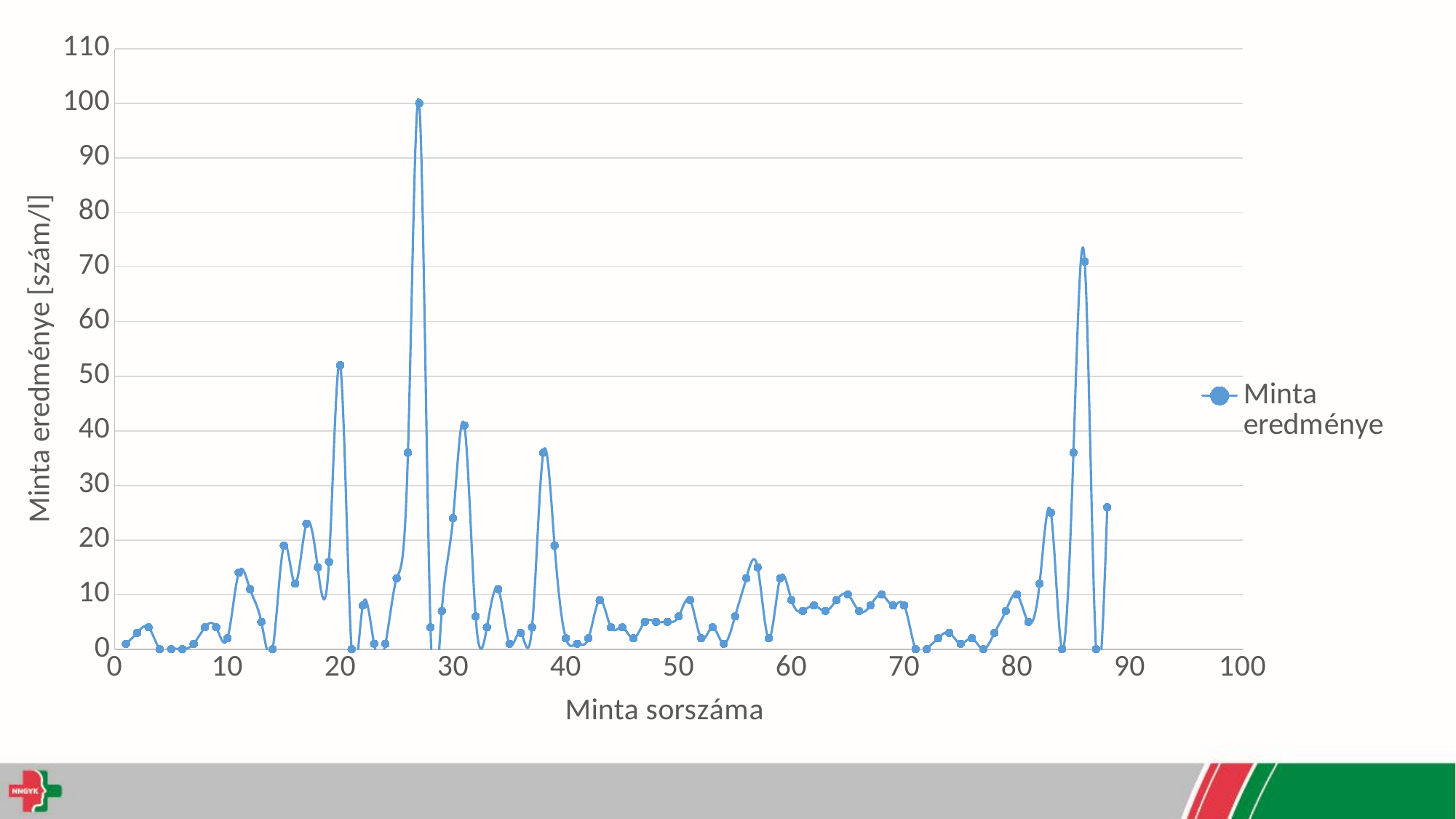
Is the peak value just before x=40 greater or less than 30? greater Between which two x-axis tick labels does the highest point of the chart fall? 20 and 30 What kind of chart is shown on the slide? line chart What is the value of the highest point on the chart? 100 How many series does the legend list? 1 What is the name of the series shown in the legend? Minta eredménye Are all the values between x=40 and x=50 greater or less than 20? less Which is higher: the peak at about x=20 or the peak just after x=30? the peak at about x=20 Is the highest value between x=80 and x=90 greater or less than 60? greater What is the title of the x axis? Minta sorszáma